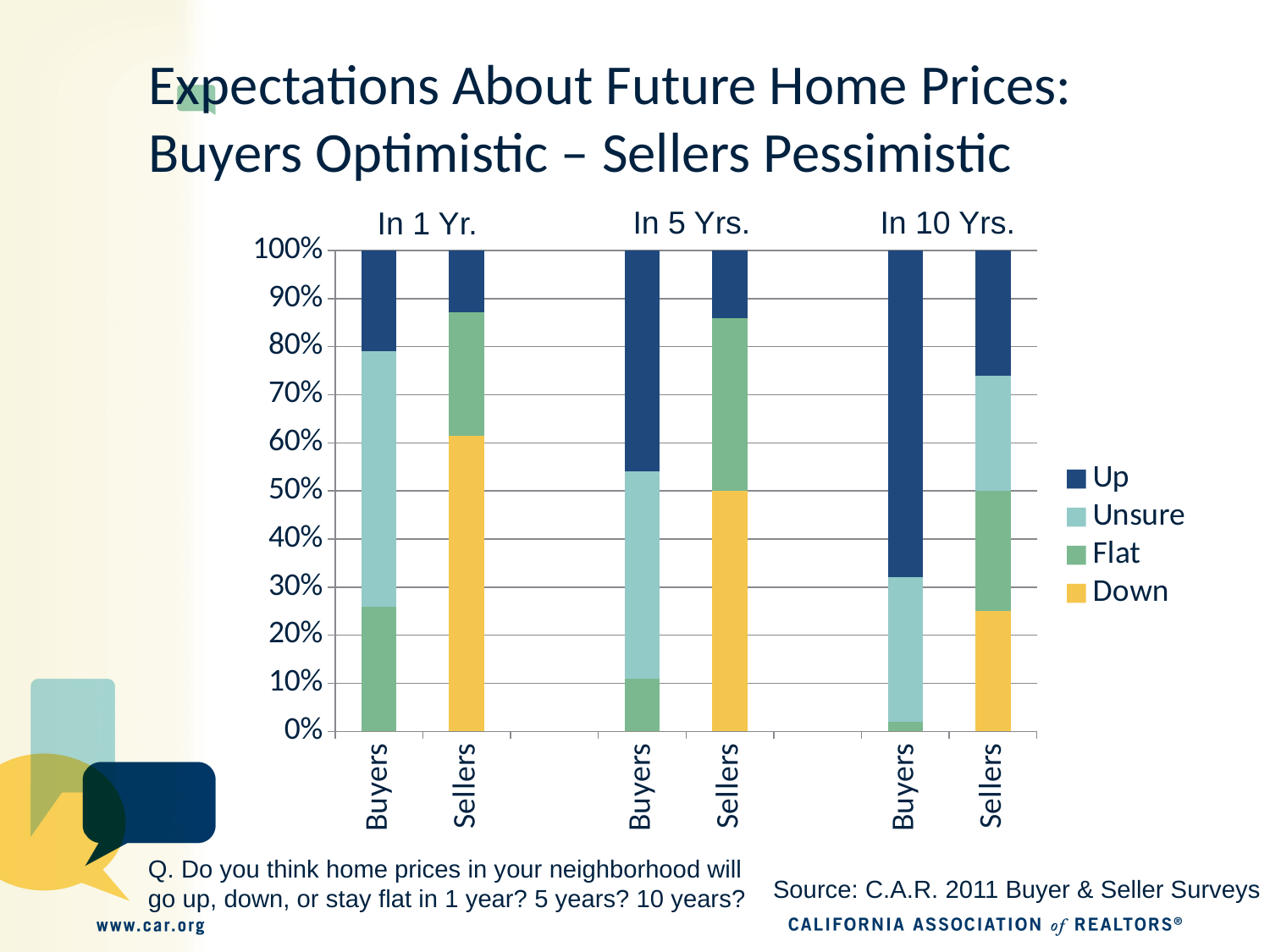
Does the Down share for Sellers rise or fall from In 1 Yr. to In 10 Yrs.? fall How many bars are plotted in the chart? 6 Is the Down share for Sellers in 10 Yrs. greater or less than 30%? less In 5 Yrs., which group has the larger Up share, Buyers or Sellers? Buyers Which series are listed in the legend? Up, Unsure, Flat, Down Does the Up share for Buyers rise or fall from In 1 Yr. to In 10 Yrs.? rise Is the Up share for Buyers in 10 Yrs. greater or less than 60%? greater What kind of chart is shown on the slide? Stacked bar chart Is the Down share for Sellers in 1 Yr. greater or less than 50%? greater How many series does the legend list? 4